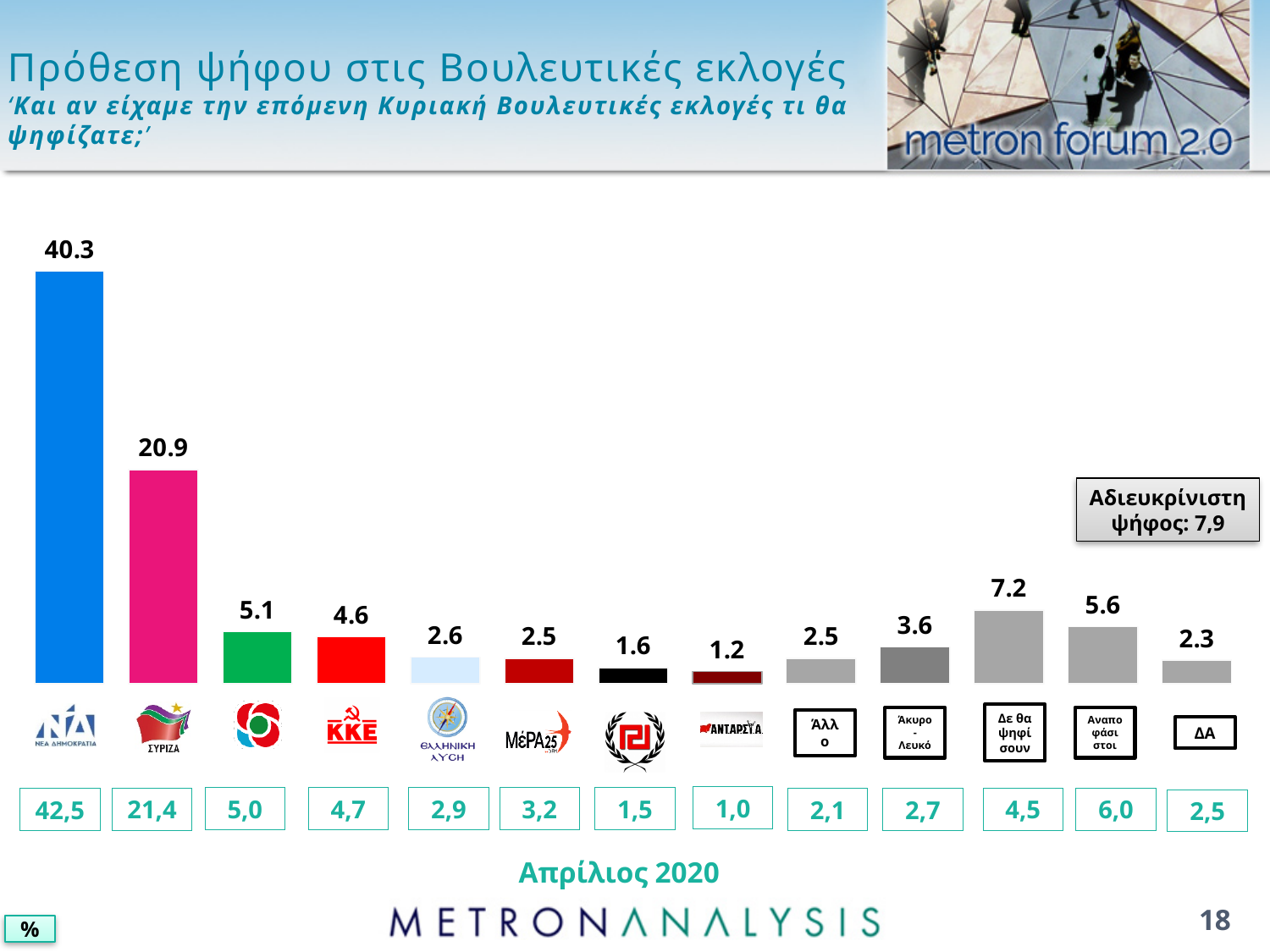
What is the value shown for 'Αναποφάσιστοι' in the bar chart? 5.6 What is the difference between the values for ΝΕΑ ΔΗΜΟΚΡΑΤΙΑ and ΣΥΡΙΖΑ? 19.4 What is the value shown for ΚΚΕ in the bar chart? 4.6 Which category has the highest bar in the chart? ΝΕΑ ΔΗΜΟΚΡΑΤΙΑ How many bars are plotted in the chart? 13 What is the value shown for ΝΕΑ ΔΗΜΟΚΡΑΤΙΑ in the bar chart? 40.3 Which is larger, the value for ΚΚΕ or the value for 'Δε θα ψηφίσουν'? Δε θα ψηφίσουν What kind of chart is shown on the slide? Bar chart What is the value shown for 'Δε θα ψηφίσουν' in the bar chart? 7.2 What value is given in the box labelled 'Αδιευκρίνιστη ψήφος'? 7,9 What is the value shown for ΣΥΡΙΖΑ in the bar chart? 20.9 Which category has the lowest bar in the chart? ΑΝΤΑΡΣΥΑ